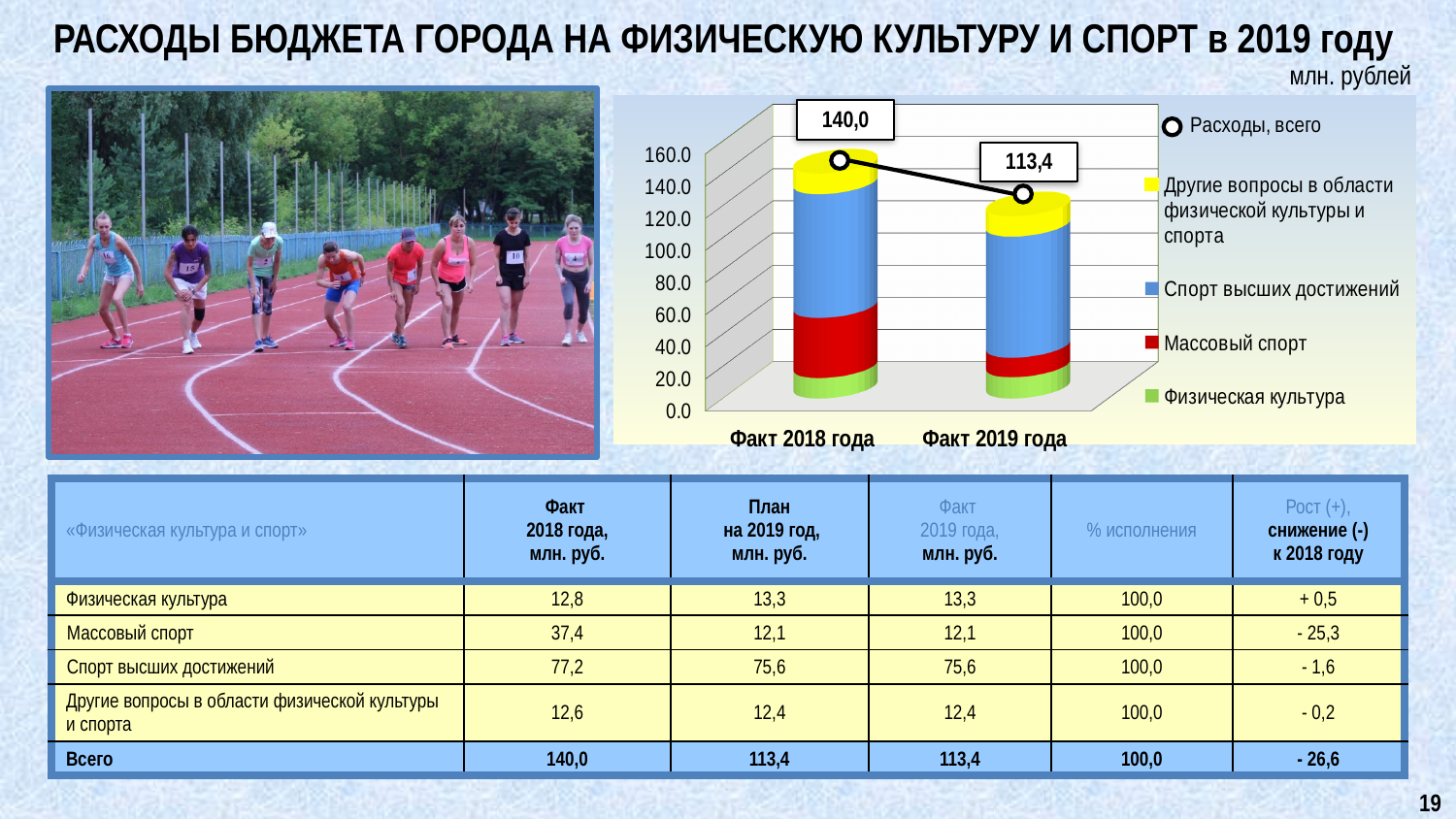
How many categories are shown on the x axis of the chart? 2 What kind of chart is shown on the slide? bar chart Which is larger, Расходы, всего for Факт 2018 года or for Факт 2019 года? Факт 2018 года Does Расходы, всего rise or fall from Факт 2018 года to Факт 2019 года? fall By how much does Расходы, всего for Факт 2018 года exceed that for Факт 2019 года? 26,6 How many series does the chart legend list? 5 What is the value of Расходы, всего for Факт 2018 года? 140,0 What is the value of Расходы, всего for Факт 2019 года? 113,4 Which series is shown in red in the chart? Массовый спорт In what units are the chart values given, according to the label above the chart? млн. рублей Is the value of Расходы, всего for Факт 2019 года greater or less than 120? less Which category has the highest value of Расходы, всего? Факт 2018 года